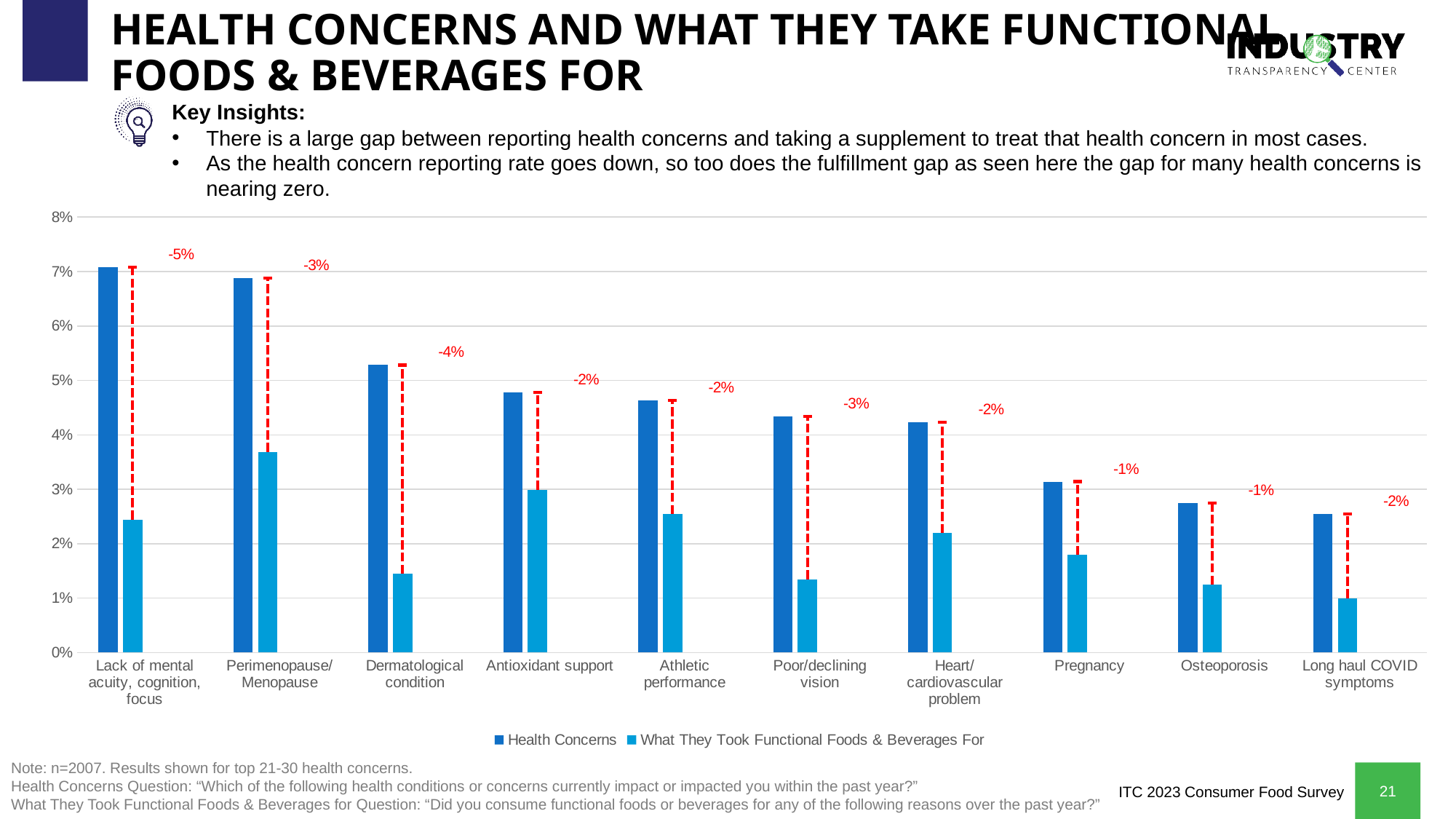
What gap value is labelled above the bars for Long haul COVID symptoms? -2% What gap value is labelled above the bars for Dermatological condition? -4% Do the Health Concerns values rise or fall moving from left to right across the categories? fall Is the Health Concerns value for Lack of mental acuity, cognition, focus greater or less than 6%? greater What gap value is labelled above the bars for Pregnancy? -1% How many health concern categories are shown on the x axis? 10 What kind of chart is shown on the slide? bar chart Which category has the highest value for What They Took Functional Foods & Beverages For? Perimenopause/Menopause What gap value is labelled above the bars for Lack of mental acuity, cognition, focus? -5% Which is larger: the What They Took Functional Foods & Beverages For value for Perimenopause/Menopause or for Dermatological condition? Perimenopause/Menopause How many series does the legend list? 2 Is the What They Took Functional Foods & Beverages For value for Dermatological condition greater or less than 2%? less